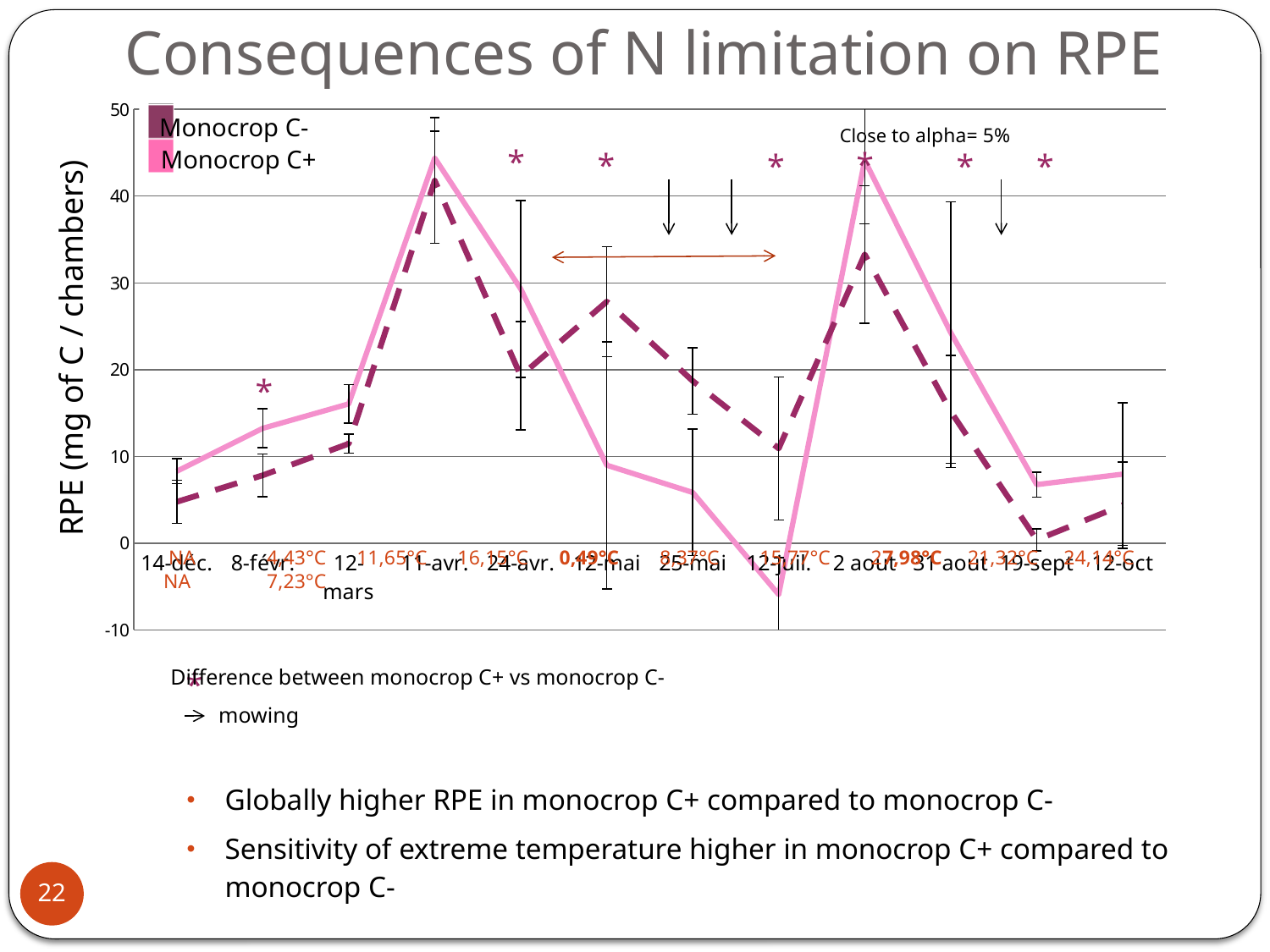
Is the value for Monocrop C+ at 12-juil. greater or less than 0? less At which date does Monocrop C+ reach its lowest value? 12-juil. At which date does Monocrop C- reach its highest value? 11-avr. What kind of chart is shown on the slide? line chart How many series does the legend list? 2 What is the label of the y axis? RPE (mg of C / chambers) Which two series are listed in the legend? Monocrop C- and Monocrop C+ At 12-mai, which series has the higher value, Monocrop C+ or Monocrop C-? Monocrop C- Is the value for Monocrop C+ at 2 aout greater or less than 40? greater Is the value for Monocrop C- at 12-mai greater or less than 20? greater Does the Monocrop C+ line rise or fall from 11-avr. to 12-juil.? fall How many dates are plotted along the x axis? 12